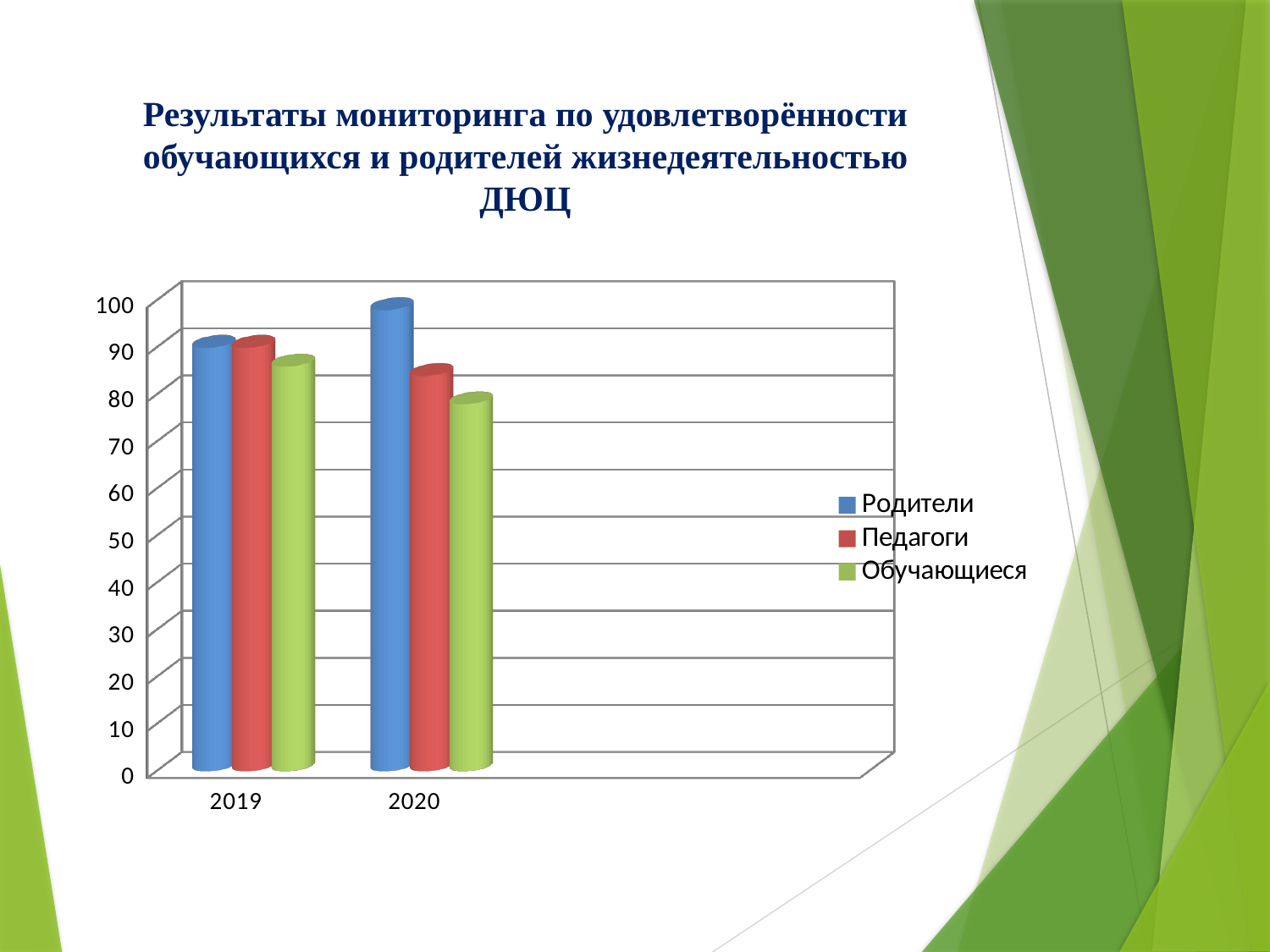
How many series does the legend list? 3 Is the value for Родители in 2019 greater or less than 80? greater Which is larger: the value for Родители in 2020 or the value for Педагоги in 2020? Родители in 2020 What kind of chart is shown on the slide? bar chart How many categories (years) are shown on the x axis? 2 Does the value for Родители rise or fall from 2019 to 2020? rise Is the value for Педагоги in 2020 greater or less than 90? less Which series has the highest value in 2020? Родители Is the value for Родители in 2020 greater or less than 90? greater Which series has the lowest value in 2020? Обучающиеся Which colour represents the Педагоги series in the legend? red Does the value for Обучающиеся rise or fall from 2019 to 2020? fall